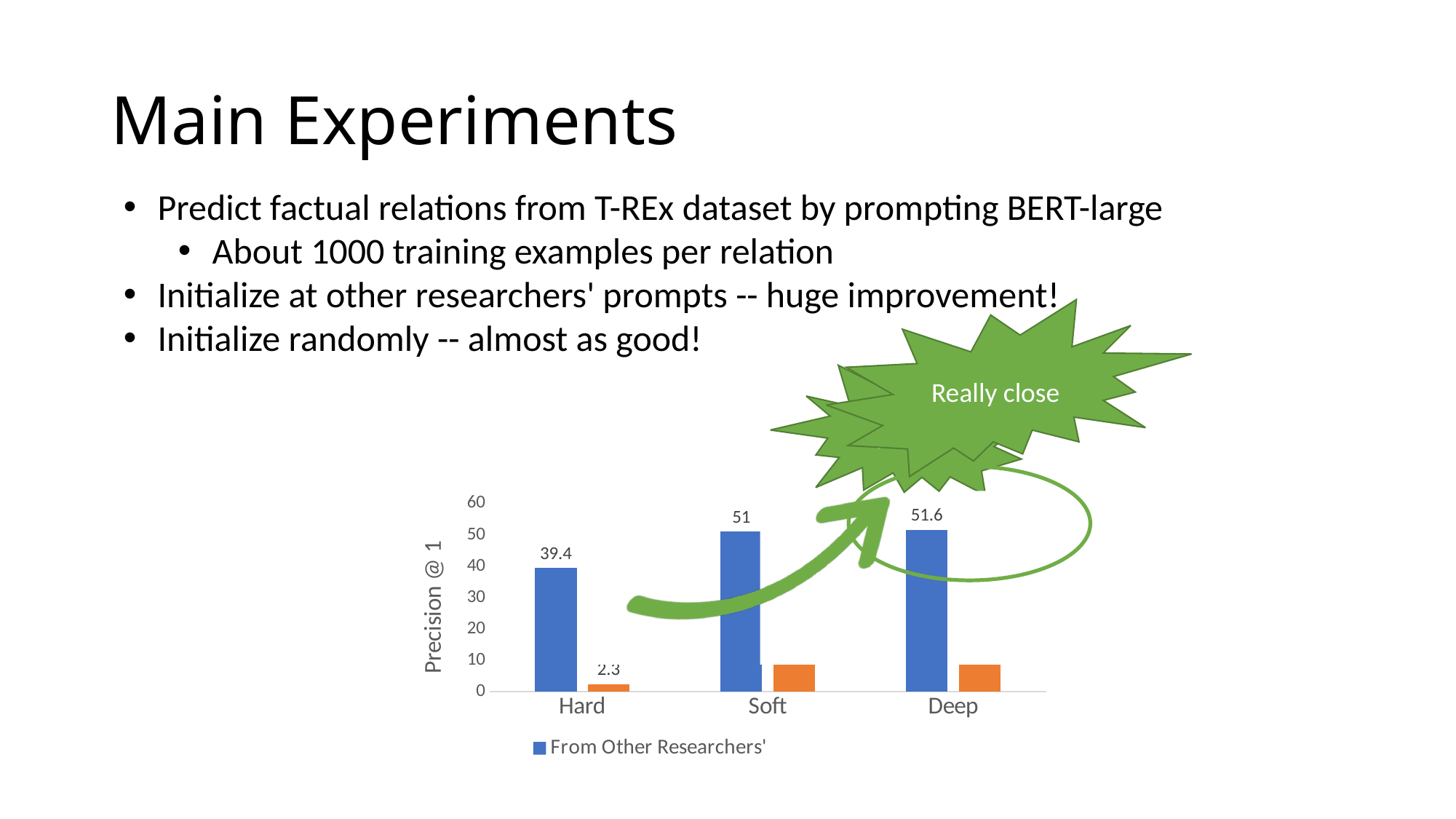
What is the difference between the From Other Researchers' values for Soft and Hard? 11.6 What is the value of the From Other Researchers' bar for Deep? 51.6 Which category has the lowest From Other Researchers' value? Hard What is the title of the y axis? Precision @ 1 Which is larger, the From Other Researchers' value for Hard or for Soft? Soft What is the value of the From Other Researchers' bar for Hard? 39.4 Which category has the highest From Other Researchers' value? Deep How many categories are shown on the x axis? 3 What kind of chart is shown on the slide? bar chart What is the value of the From Other Researchers' bar for Soft? 51 What is the value of the orange bar for Hard? 2.3